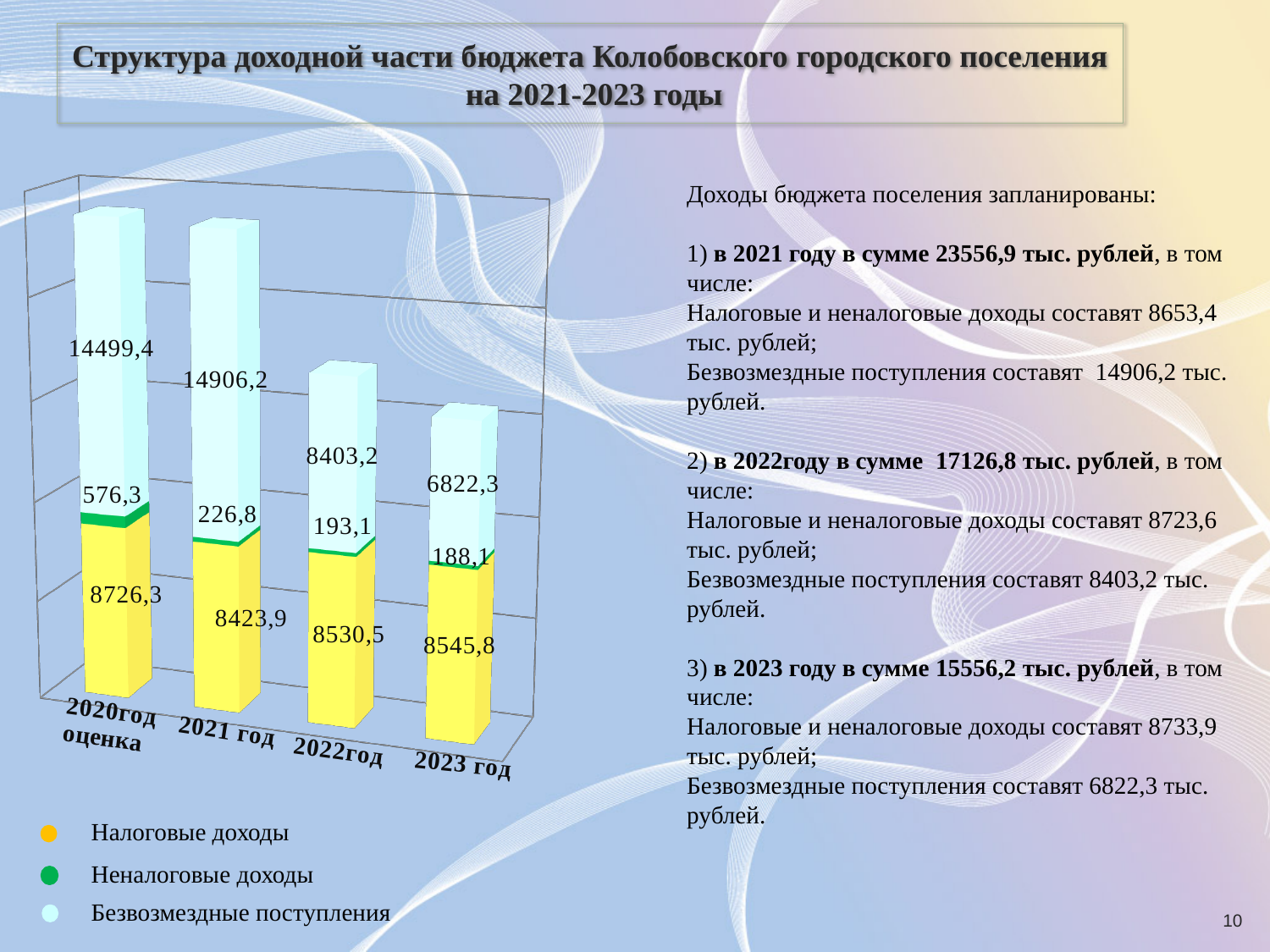
What is the difference between Безвозмездные поступления in 2021 год and in 2023 год? 8083,9 How many series does the chart legend list? 3 In which year is the value of Безвозмездные поступления the highest? 2021 год What type of chart is shown on the slide? stacked bar chart What is the total of the stacked bar for 2022год? 17126,8 What is the value of Безвозмездные поступления for 2021 год? 14906,2 Which is larger: Налоговые доходы in 2020год оценка or in 2021 год? 2020год оценка In which year is the value of Неналоговые доходы the lowest? 2023 год What is the value of Неналоговые доходы for 2020год оценка? 576,3 Do the values of Неналоговые доходы rise or fall from 2020год оценка to 2023 год? fall What is the value of Налоговые доходы for 2022год? 8530,5 How many year categories are plotted along the x axis of the chart? 4